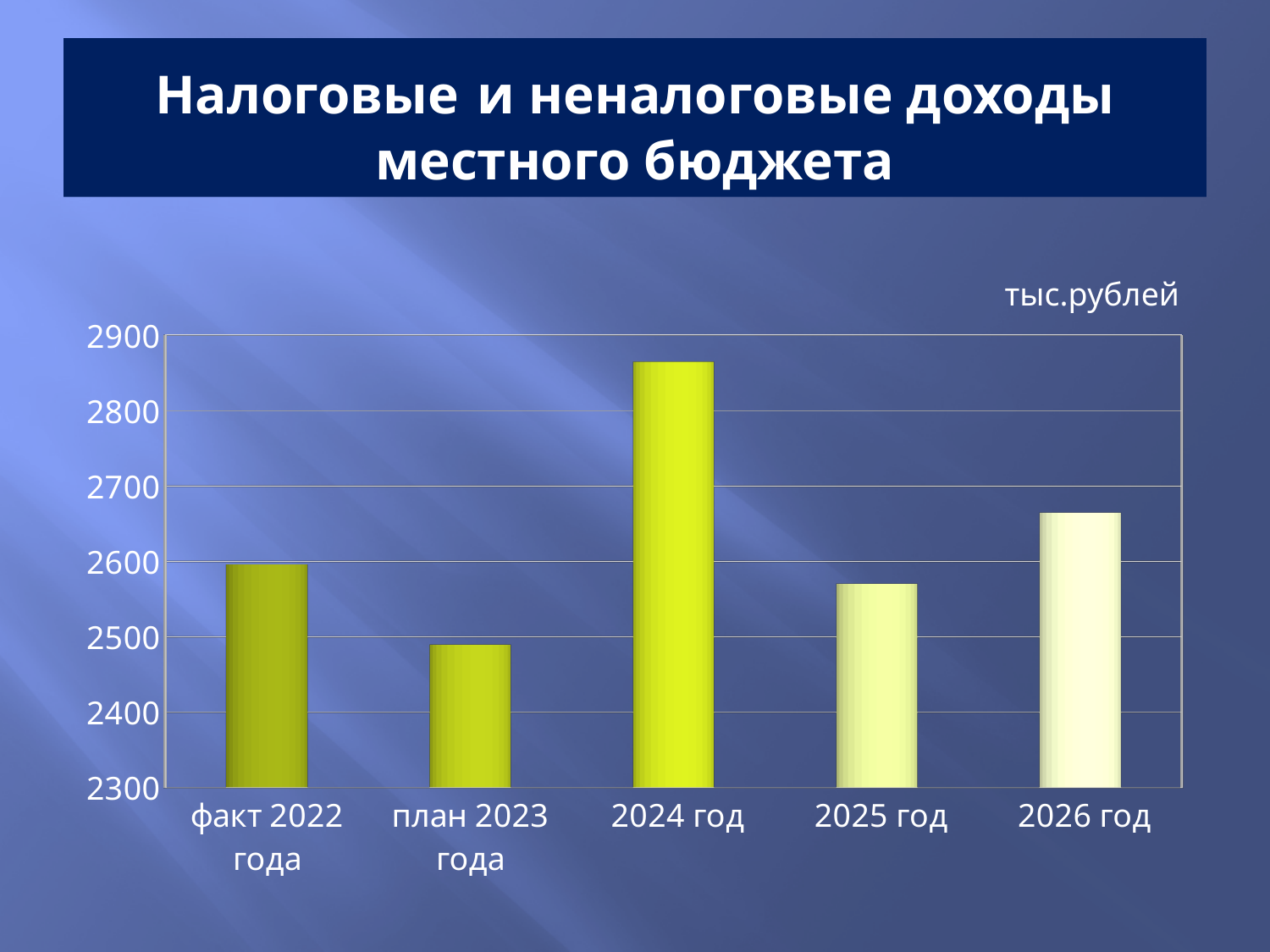
Is the value for 2024 год greater or less than 2800? greater Is the value for 2026 год greater or less than 2700? less Is the value for 2025 год greater or less than 2600? less Which is larger, the value for 2025 год or the value for 2026 год? 2026 год What unit of measurement is indicated above the chart? тыс.рублей What kind of chart is shown on the slide? bar chart Which category has the lowest value in the chart? план 2023 года Which category has the highest value in the chart? 2024 год How many categories are shown on the x axis of the chart? 5 Which is larger, the value for факт 2022 года or the value for план 2023 года? факт 2022 года